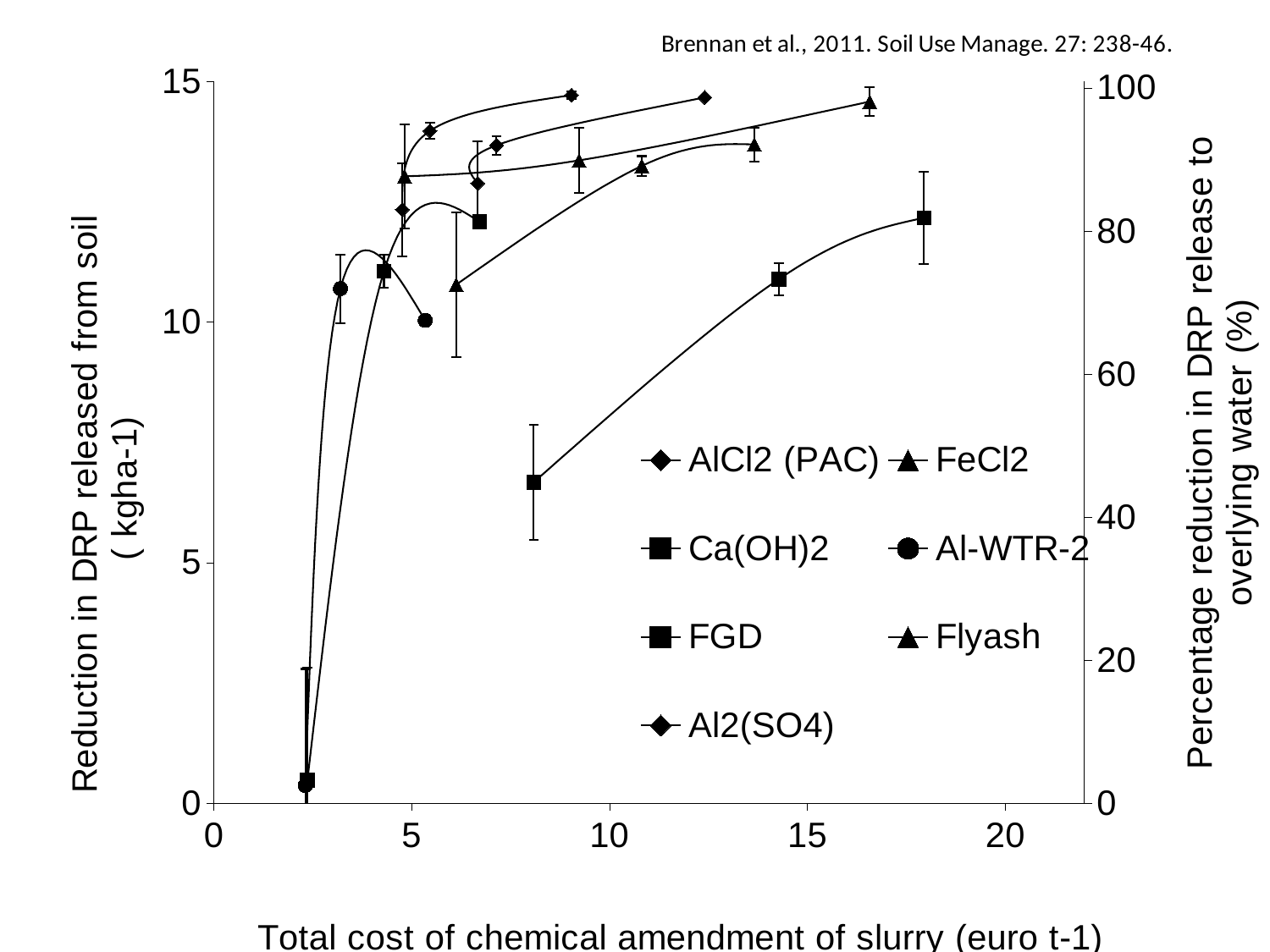
In general, do the plotted values rise or fall as the total cost increases along the x axis? Rise What is the title of the right-hand y axis? Percentage reduction in DRP release to overlying water (%) What is the maximum value shown on the left y axis? 15 What is the maximum value shown on the right y axis? 100 What kind of chart is shown on the slide? Line chart with markers (scatter with fitted curves) What is the title of the x axis? Total cost of chemical amendment of slurry (euro t-1) What is the maximum value labelled on the x axis? 20 How many series does the legend list? 7 Is the lowest plotted point on the chart greater or less than 5 on the left axis? less Is the highest plotted point on the chart greater or less than 10 on the left axis? greater